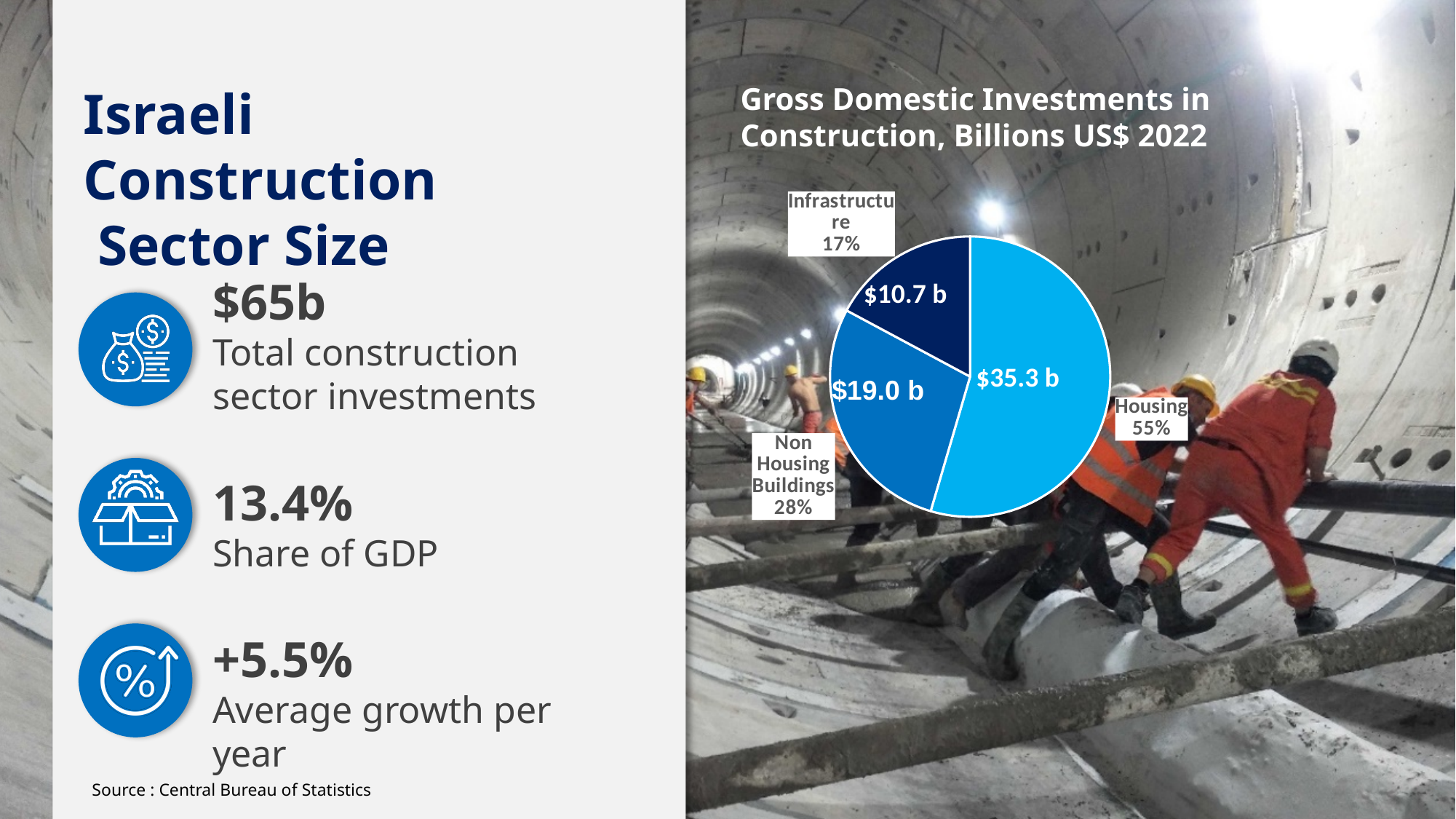
What share of the pie does Infrastructure represent? 17% What is the value for Housing in the pie chart? $35.3 b What is the value for Non Housing Buildings in the pie chart? $19.0 b What is the title of the pie chart? Gross Domestic Investments in Construction, Billions US$ 2022 Which is larger in the pie chart, Non Housing Buildings or Infrastructure? Non Housing Buildings Which category has the smallest slice of the pie chart? Infrastructure Which category has the largest slice of the pie chart? Housing What share of the pie does Non Housing Buildings represent? 28% What is the value for Infrastructure in the pie chart? $10.7 b How many categories are shown in the pie chart? 3 What share of the pie does Housing represent? 55% What type of chart is shown on the slide? Pie chart